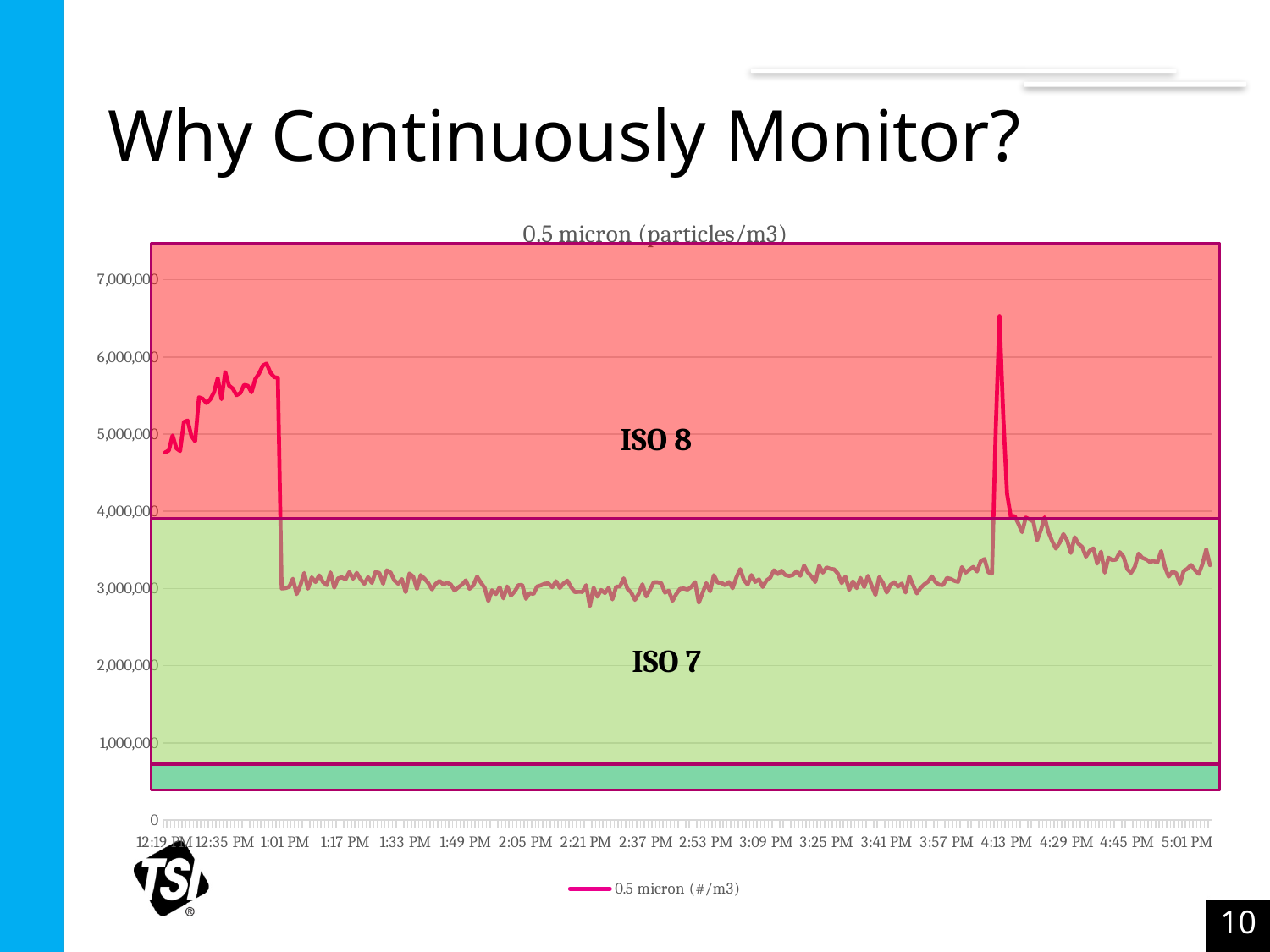
Which ISO class label appears in the red shaded region of the chart? ISO 8 What is the title of the chart? 0.5 micron (particles/m3) Is the value at 12:19 PM greater or less than 4,000,000? greater What kind of chart is shown on the slide? line chart Is the value at 1:33 PM greater or less than 2,000,000? greater How many time labels are shown along the x axis? 18 Is the value at 2:05 PM greater or less than 4,000,000? less How many series does the legend list? 1